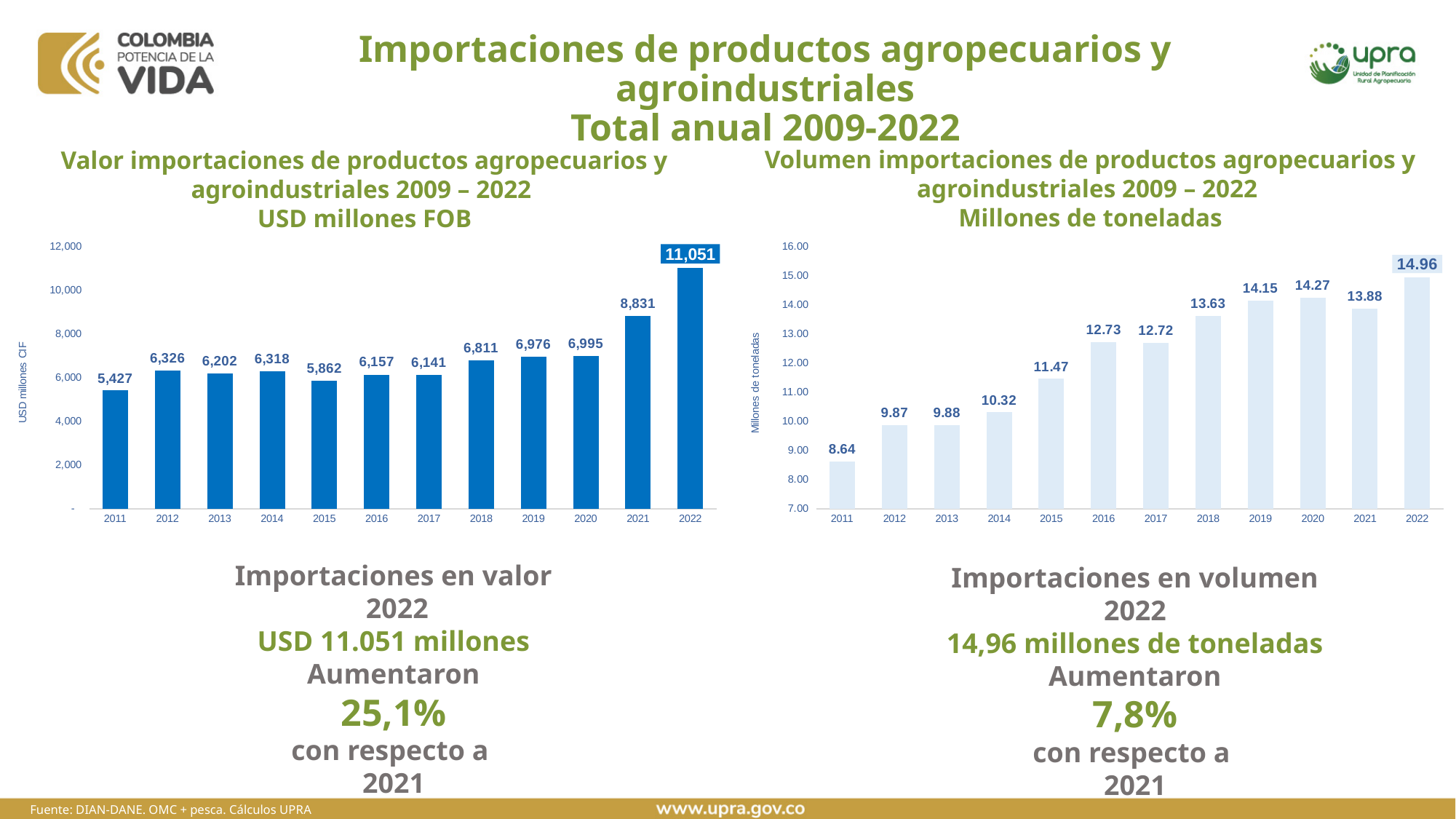
In the left chart (Valor importaciones), what is the value for 2022? 11,051 In the right chart (Volumen importaciones), which is larger, the value for 2020 or the value for 2021? 2020 In the left chart (Valor importaciones), which is larger, the value for 2012 or the value for 2014? 2012 In the left chart (Valor importaciones), how many years are shown on the x axis? 12 In the right chart (Volumen importaciones), what is the difference between the 2022 and 2021 values? 1.08 In the left chart (Valor importaciones), what is the difference between the 2022 and 2021 values? 2,220 In the right chart (Volumen importaciones), what is the value for 2016? 12.73 In the left chart (Valor importaciones), what is the value for 2015? 5,862 In the left chart (Valor importaciones), which year has the lowest value? 2011 In the right chart (Volumen importaciones), which year has the highest value? 2022 In the right chart (Volumen importaciones), what is the unit shown in the chart title? Millones de toneladas What kind of chart is the right chart (Volumen importaciones)? Bar chart